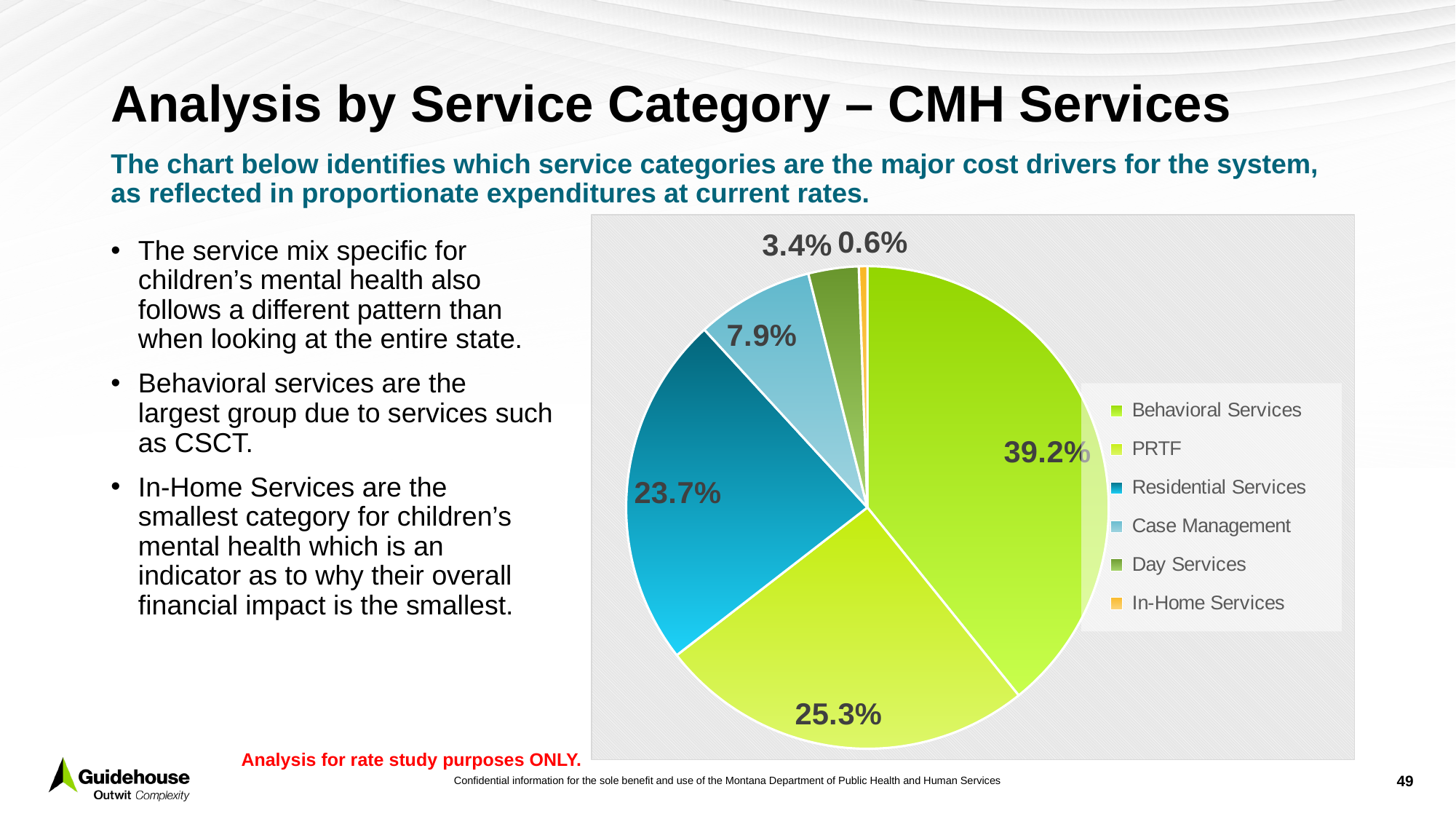
What share of the pie does Day Services account for? 3.4% What share of the pie does Residential Services account for? 23.7% What share of the pie does PRTF account for? 25.3% What share of the pie does In-Home Services account for? 0.6% Which service category has the smallest share of the pie? In-Home Services Which has a larger share, Case Management or Day Services? Case Management How many service categories does the legend list? 6 What share of the pie does Behavioral Services account for? 39.2% What share of the pie does Case Management account for? 7.9% What kind of chart is shown on the slide? Pie chart Which service category has the largest share of the pie? Behavioral Services What is the difference in percentage points between the Behavioral Services share and the PRTF share? 13.9